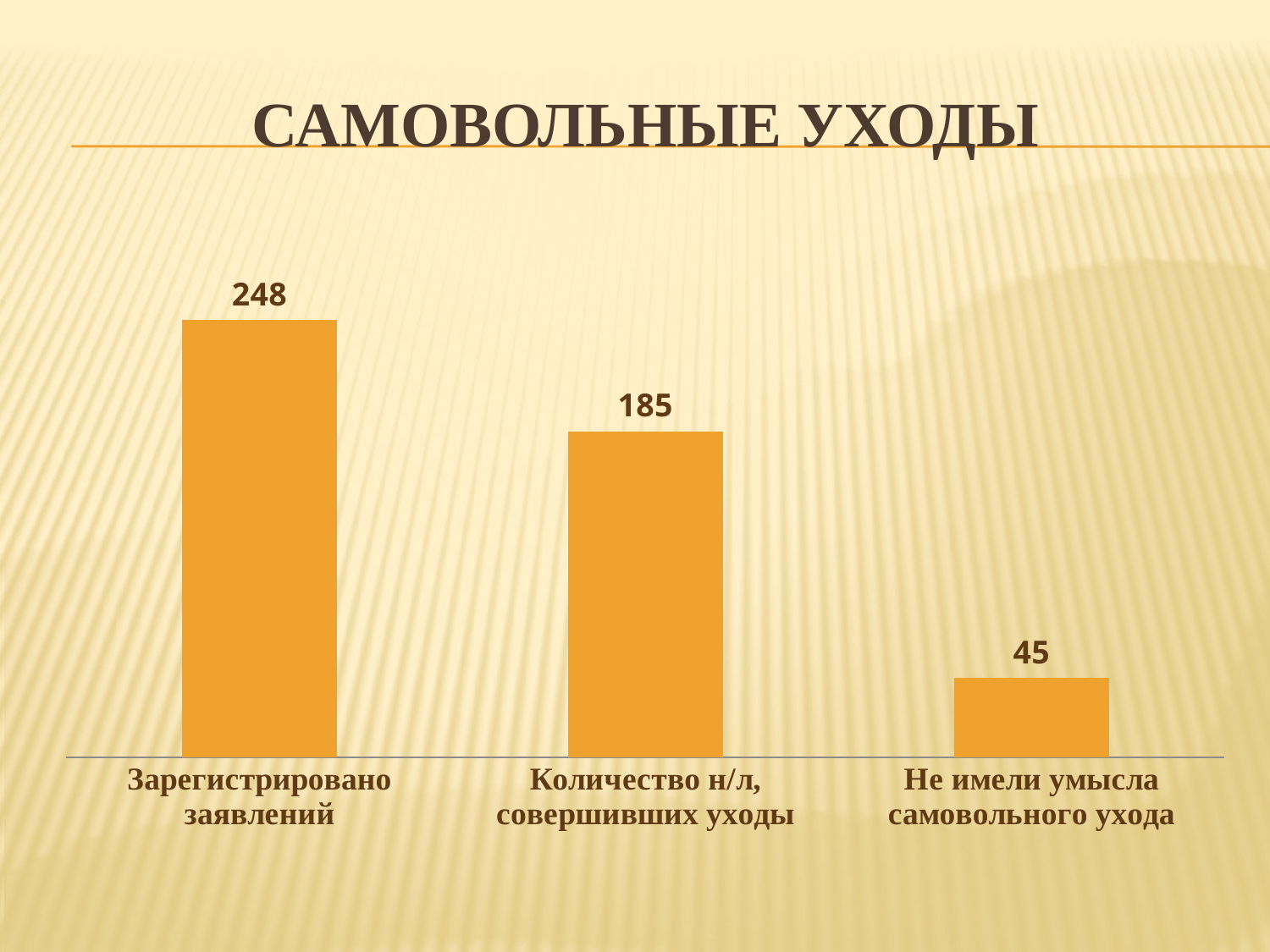
What is the difference between "Количество н/л, совершивших уходы" and "Не имели умысла самовольного ухода"? 140 How many categories are shown in the chart? 3 What is the value for "Количество н/л, совершивших уходы"? 185 What is the title of the slide? САМОВОЛЬНЫЕ УХОДЫ What is the value for "Зарегистрировано заявлений"? 248 What is the difference between "Зарегистрировано заявлений" and "Количество н/л, совершивших уходы"? 63 What is the value for "Не имели умысла самовольного ухода"? 45 Which is larger: "Количество н/л, совершивших уходы" or "Не имели умысла самовольного ухода"? Количество н/л, совершивших уходы Which category has the highest value? Зарегистрировано заявлений What kind of chart is shown on the slide? Bar chart Which category has the lowest value? Не имели умысла самовольного ухода Do the values rise or fall from left to right across the categories? Fall